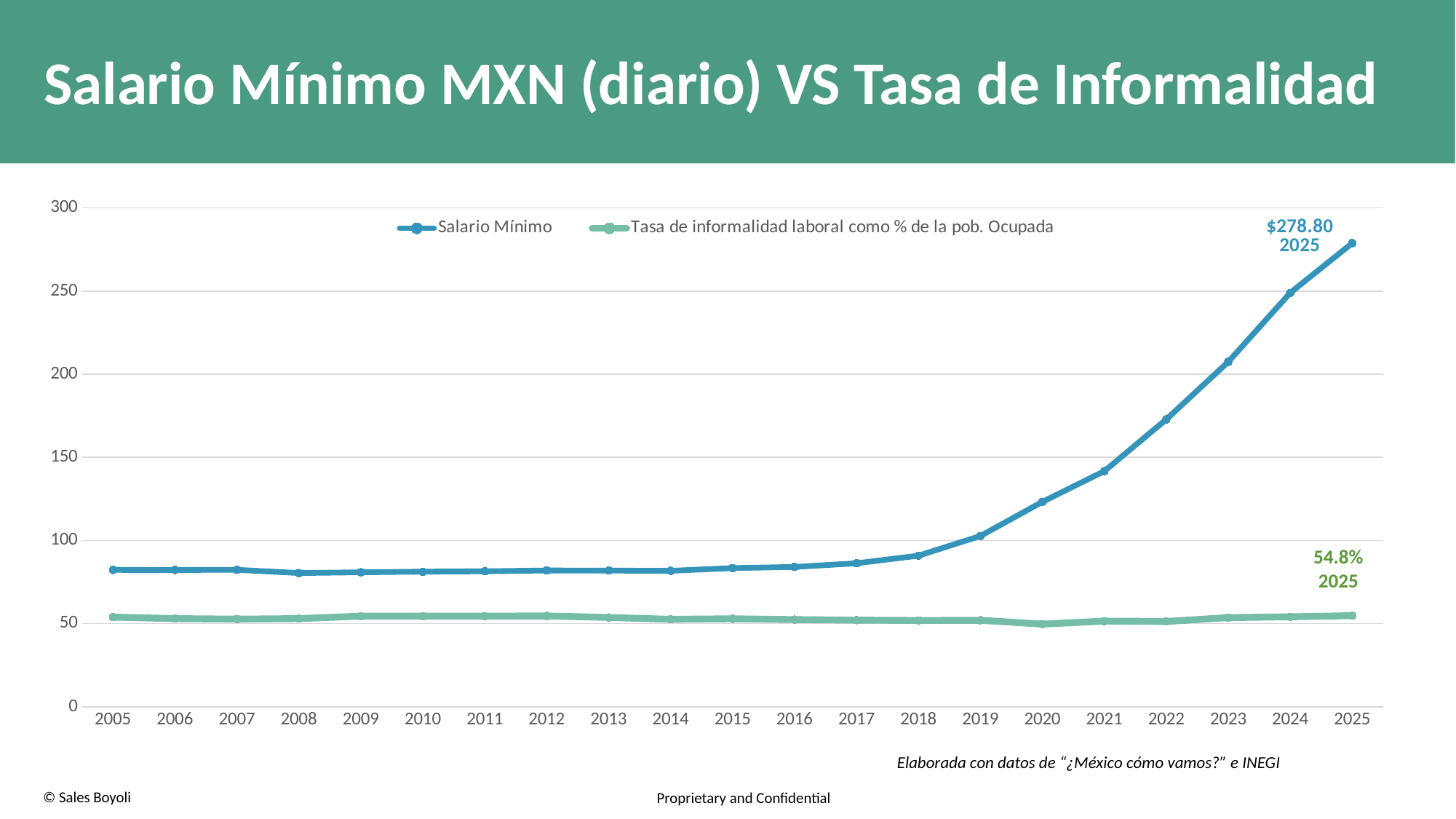
In which year is Tasa de informalidad laboral como % de la pob. Ocupada lowest? 2020 In which year is Salario Mínimo highest? 2025 What kind of chart is shown on the slide? Line chart What is the title of the slide? Salario Mínimo MXN (diario) VS Tasa de Informalidad What is the value of Tasa de informalidad laboral como % de la pob. Ocupada in 2025? 54.8% Does Salario Mínimo rise or fall from 2018 to 2025? Rise Is the value for Salario Mínimo in 2020 greater or less than 100? greater Is the value for Salario Mínimo in 2010 greater or less than 100? less How many years are plotted along the x axis? 21 What is the value of Salario Mínimo in 2025? $278.80 How many series does the legend list? 2 Is the value for Salario Mínimo in 2022 greater or less than 150? greater